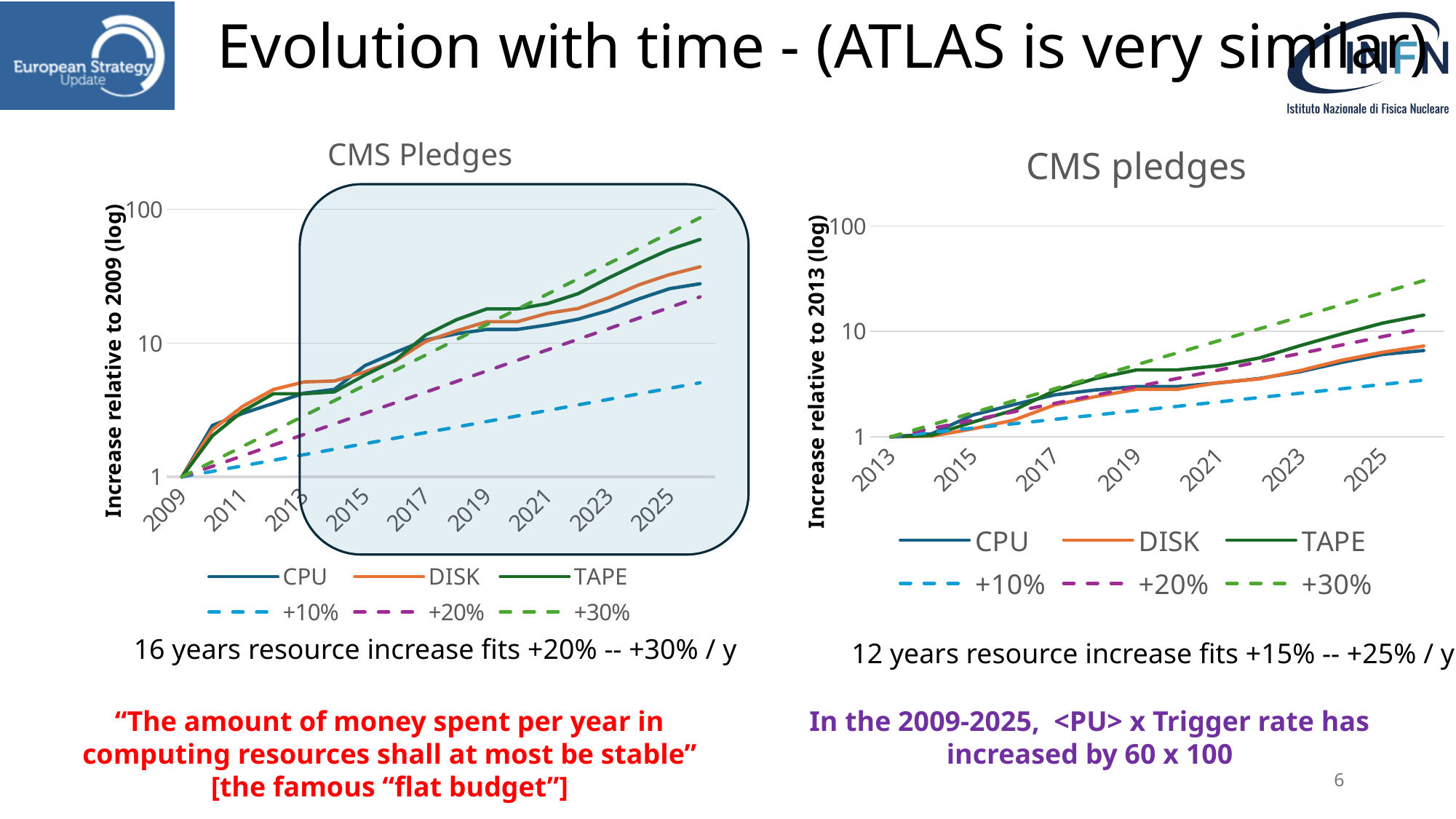
What type of chart is the left chart titled 'CMS Pledges'? line chart In the left chart (relative to 2009), is the +10% line value in 2025 greater or less than 10? less In the right chart (relative to 2013), which series is lowest in 2025? +10% In the right chart (relative to 2013), which is larger in 2025, TAPE or DISK? TAPE In the right chart (relative to 2013), is the CPU value in 2025 greater or less than 10? less In the left chart (relative to 2009), is the TAPE value in 2025 greater or less than 10? greater In the left chart (relative to 2009), which of the solid series (CPU, DISK, TAPE) is highest in 2025? TAPE How many series does the legend of the right chart (relative to 2013) list? 6 What is the y-axis label of the right chart? Increase relative to 2013 (log) How many series does the legend of the left chart (relative to 2009) list? 6 In the left chart (relative to 2009), do the CPU values rise or fall from 2009 to 2025? rise